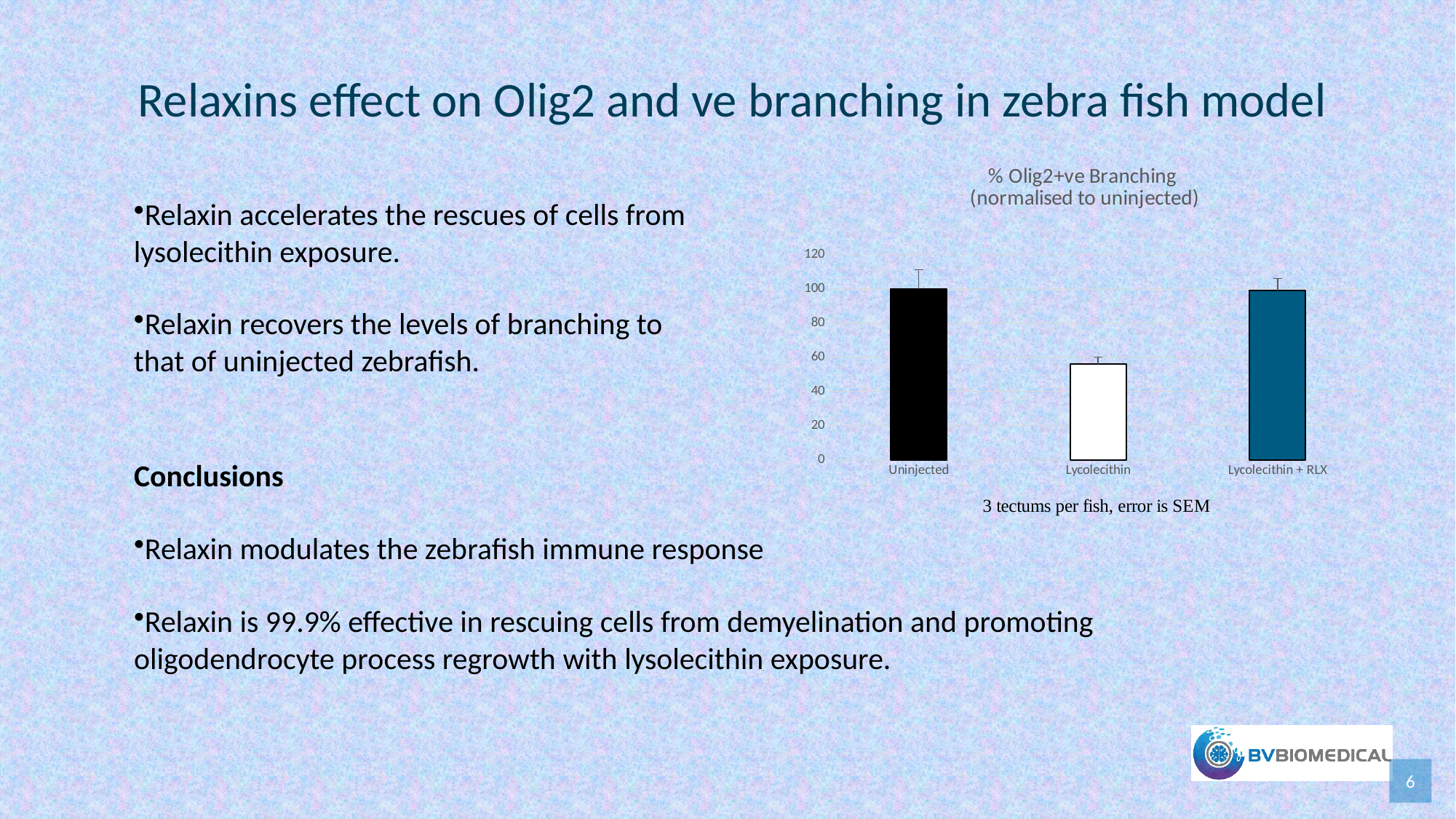
What kind of chart is shown on the slide? bar chart Is the value for Lycolecithin + RLX greater or less than 80? greater What is the title of the chart? % Olig2+ve Branching (normalised to uninjected) Which is larger, the value for Lycolecithin + RLX or the value for Lycolecithin? Lycolecithin + RLX What is the label of the third category on the x axis of the chart? Lycolecithin + RLX Which is larger, the value for Uninjected or the value for Lycolecithin? Uninjected Is the value for Lycolecithin greater or less than 80? less What is the highest value shown on the chart's vertical axis? 120 Which category has the lowest value in the chart? Lycolecithin How many categories are plotted in the chart? 3 What is the value for Uninjected in the chart? 100 Is the value for Lycolecithin greater or less than 40? greater